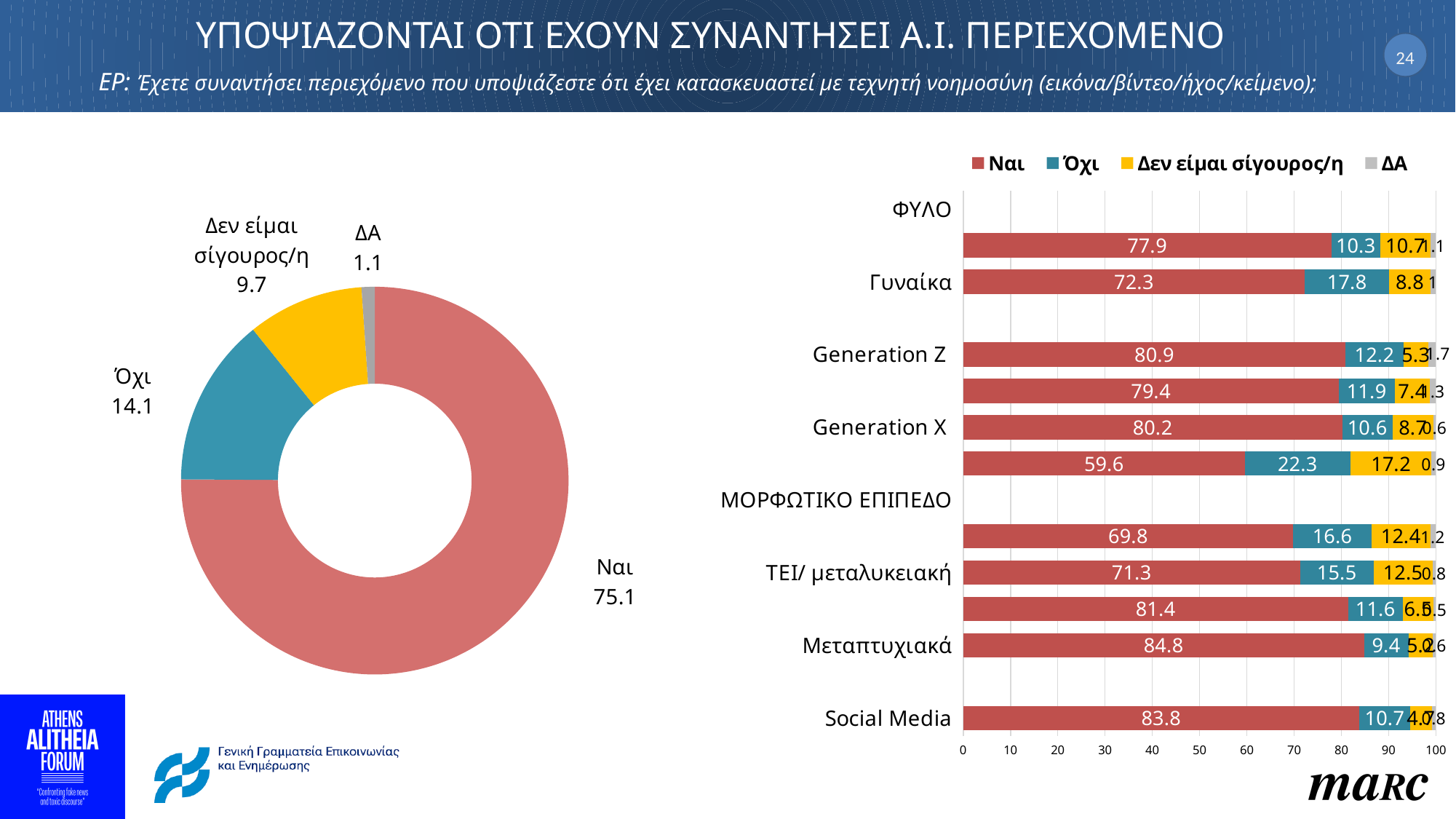
In the donut chart on the left, what is the difference between the values for Όχι and Δεν είμαι σίγουρος/η? 4.4 What kind of chart is shown on the right of the slide? Stacked bar chart In the stacked bar chart on the right, what is the Ναι value for Γυναίκα? 72.3 In the donut chart on the left, what is the value for Ναι? 75.1 In the donut chart on the left, which category has the smallest share? ΔΑ In the donut chart on the left, what is the value for Όχι? 14.1 In the stacked bar chart on the right, which has the larger Ναι value: Μεταπτυχιακά or Social Media? Μεταπτυχιακά In the stacked bar chart on the right, what is the Όχι value for Generation Z? 12.2 How many series does the legend of the stacked bar chart on the right list? 4 What kind of chart is shown on the left of the slide? Pie (donut) chart In the stacked bar chart on the right, what is the Δεν είμαι σίγουρος/η value for ΤΕΙ/ μεταλυκειακή? 12.5 In the donut chart on the left, which category has the largest share? Ναι